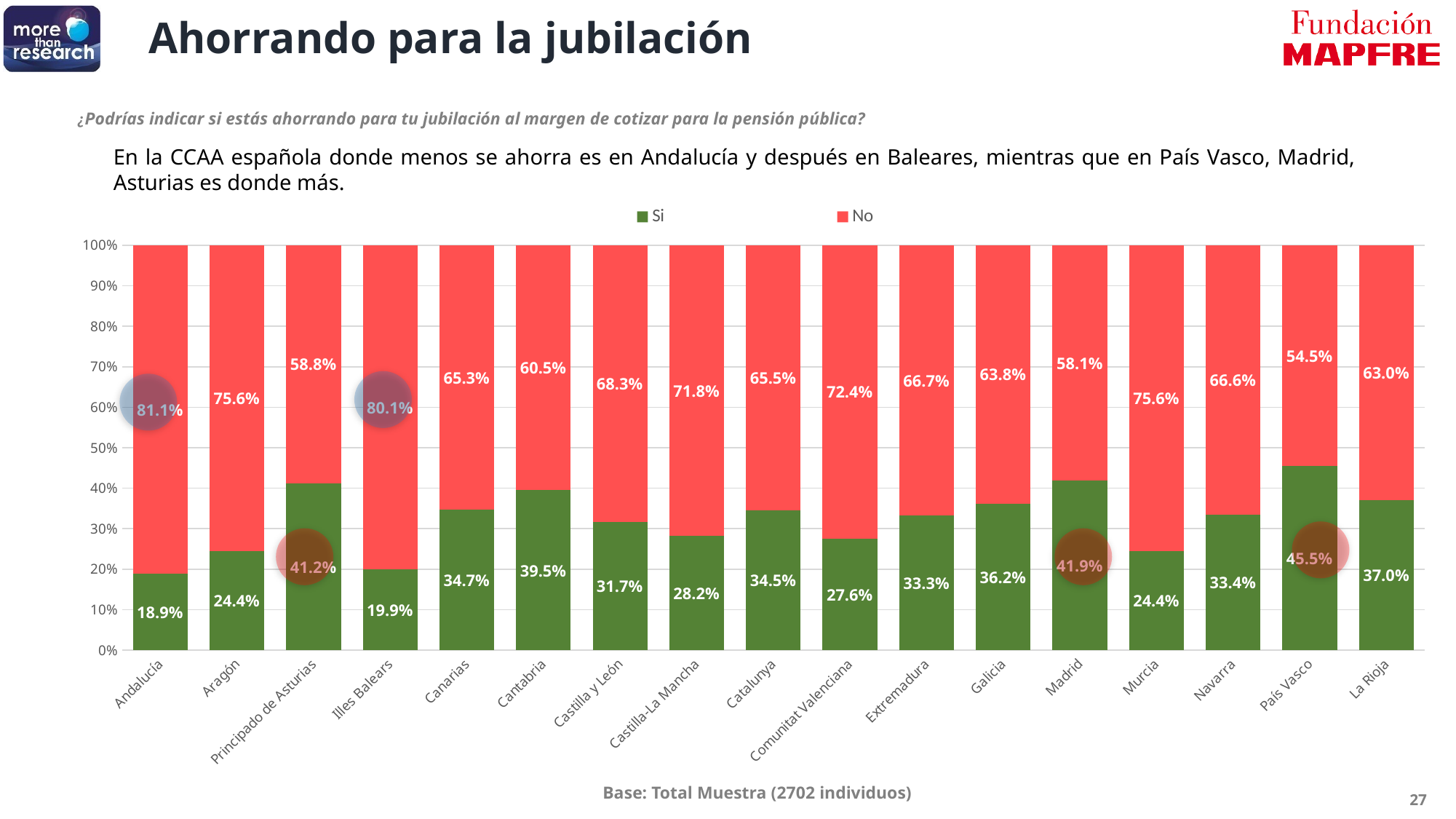
What is the 'Si' value for Andalucía? 18.9% Which region has the highest 'Si' value? País Vasco What is the difference between the 'Si' value for País Vasco and the 'Si' value for Andalucía? 26.6 percentage points What type of chart is shown on the slide? Stacked bar chart Which is larger, the 'Si' value for Cantabria or the 'Si' value for Galicia? Cantabria How many regions (categories) are shown on the x axis? 17 What is the total of the stacked bar for Murcia (Si plus No)? 100% What is the 'No' value for Illes Balears? 80.1% What is the 'Si' value for Madrid? 41.9% Which region has the lowest 'Si' value? Andalucía How many series does the legend list? 2 Which region has the highest 'No' value? Andalucía